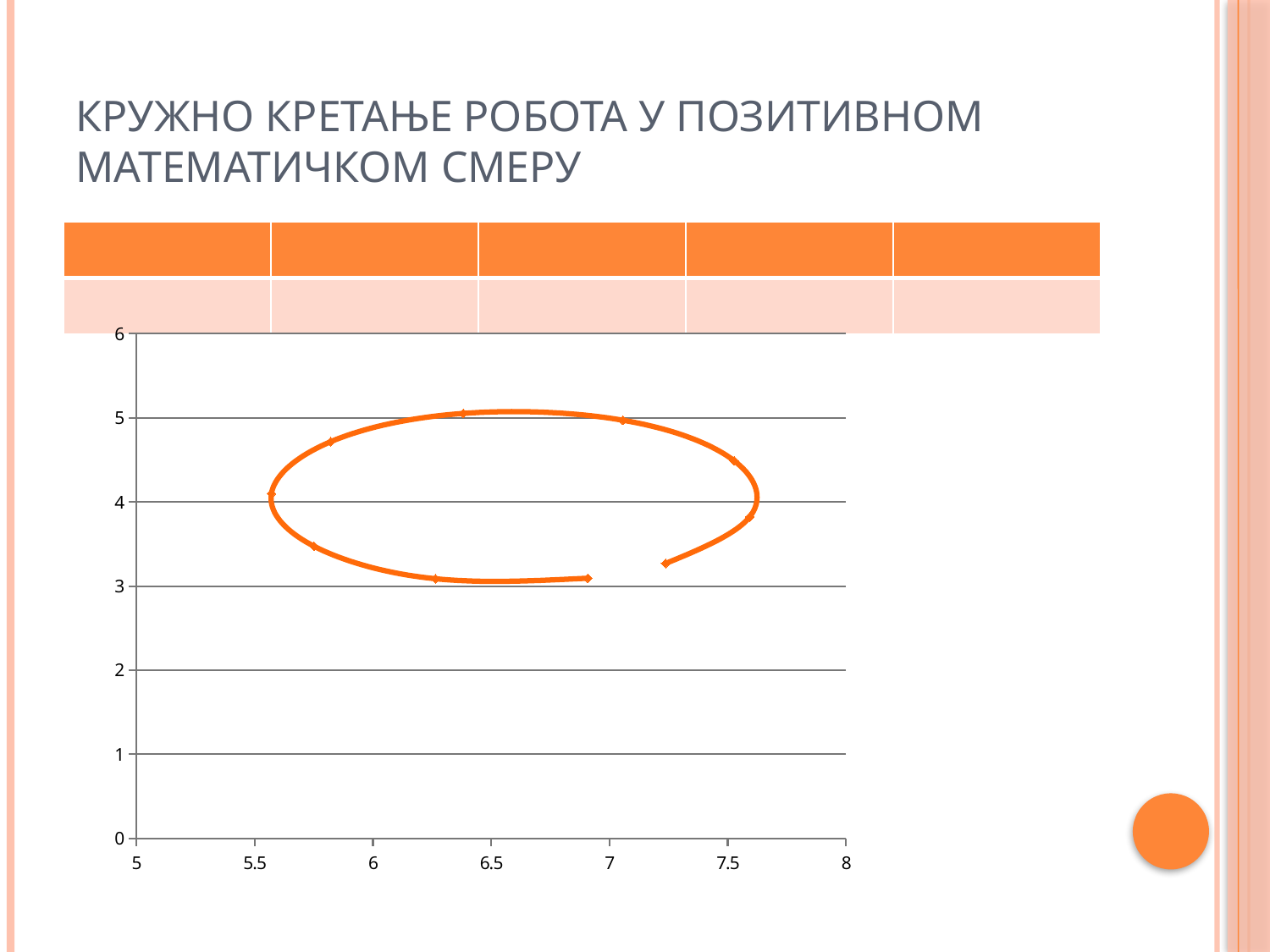
Is the x value of the leftmost plotted point greater or less than 6? less Are all plotted points above or below 2 on the y axis? above What colour is the plotted line on the chart? orange Is the y value of the lowest plotted point greater or less than 4? less How many data points are plotted on the chart? 10 What kind of chart is shown on the slide? scatter chart with a smoothed line What shape does the plotted path trace on the chart? an open elliptical loop (nearly a full ellipse, with a gap at the bottom right)